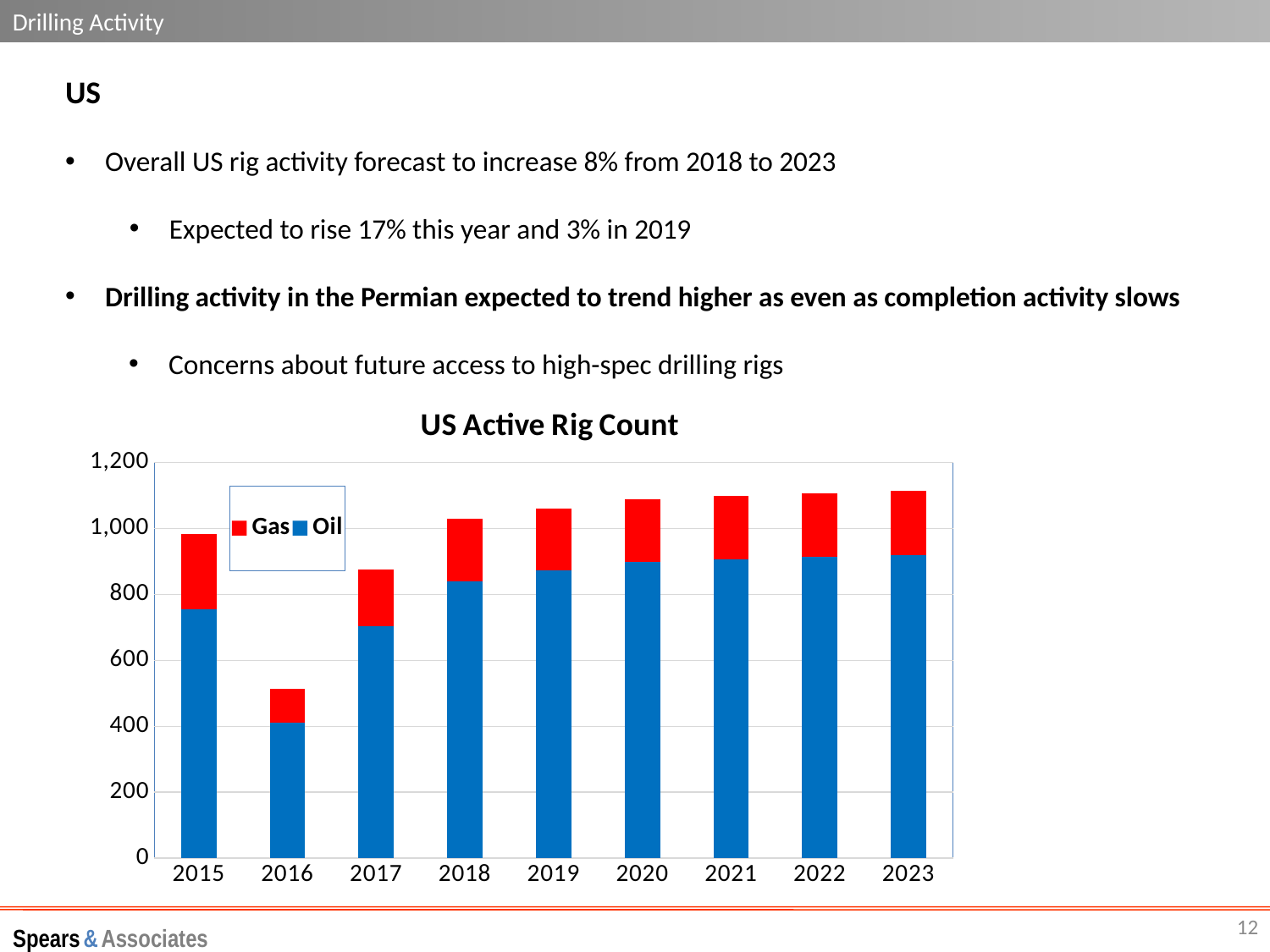
How many years are shown on the x axis of the chart? 9 How many series does the chart legend list? 2 Is the total active rig count for 2015 greater or less than 1,000? less What type of chart is shown on the slide? Stacked bar chart What is the title of the chart? US Active Rig Count Is the total active rig count for 2016 greater or less than 600? less Which year has the lowest total active rig count? 2016 Which year has the larger total active rig count, 2015 or 2017? 2015 Is the total active rig count for 2017 greater or less than 800? greater From 2017 to 2023, does the total active rig count rise or fall? Rise Which colour represents the Oil series in the chart? Blue